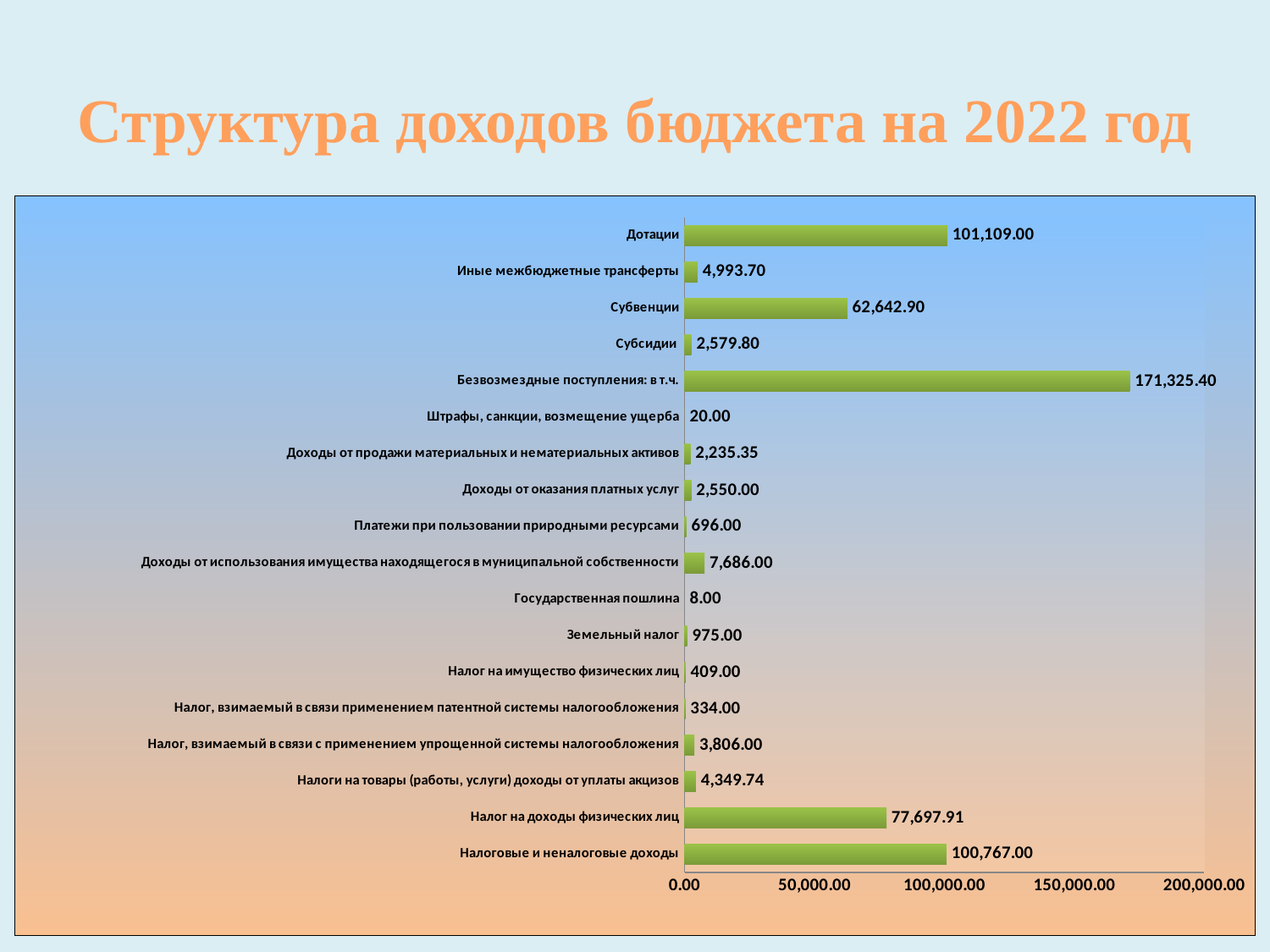
What is the value for Налог на доходы физических лиц? 77,697.91 What kind of chart is shown on the slide? bar chart What is the difference between the values for Дотации and Налоговые и неналоговые доходы? 342.00 Which is larger, the value for Дотации or the value for Налоговые и неналоговые доходы? Дотации How many categories are shown in the chart? 18 What is the value for Субвенции? 62,642.90 What is the value for Штрафы, санкции, возмещение ущерба? 20.00 What is the value for Дотации? 101,109.00 Which category has the lowest value? Государственная пошлина Is the value for Субвенции greater or less than 50,000.00? greater Which category has the highest value? Безвозмездные поступления: в т.ч. What is the difference between the values for Налог на доходы физических лиц and Субвенции? 15,055.01